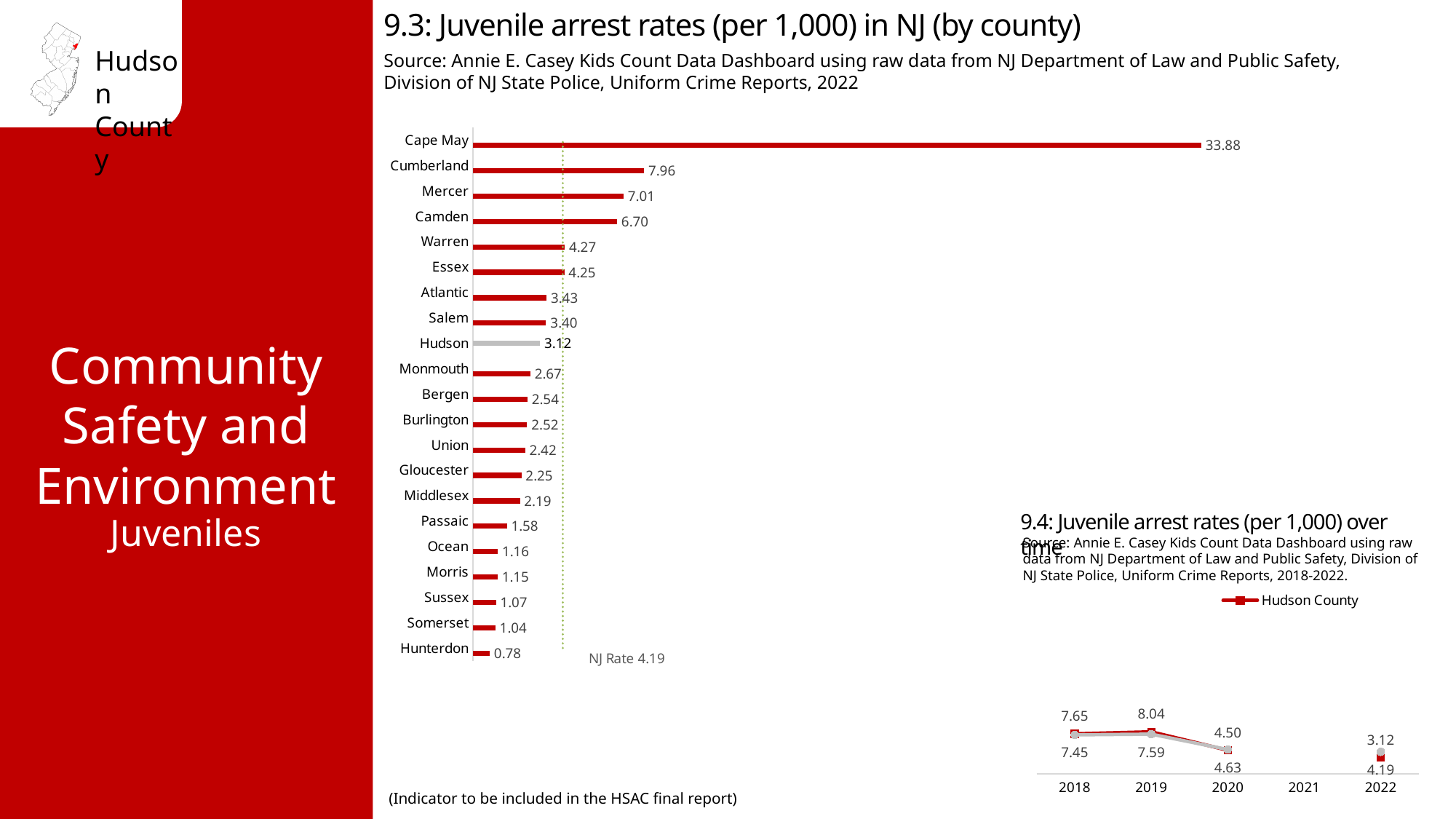
In the chart '9.4: Juvenile arrest rates (per 1,000) over time', what is the Hudson County value for 2022? 3.12 In the chart '9.3: Juvenile arrest rates (per 1,000) in NJ (by county)', what is the difference between the rates for Cape May and Cumberland? 25.92 In the chart '9.3: Juvenile arrest rates (per 1,000) in NJ (by county)', what is the juvenile arrest rate for Hudson? 3.12 In the chart '9.3: Juvenile arrest rates (per 1,000) in NJ (by county)', which county has the lowest juvenile arrest rate? Hunterdon In the chart '9.3: Juvenile arrest rates (per 1,000) in NJ (by county)', which county has the highest juvenile arrest rate? Cape May In the chart '9.3: Juvenile arrest rates (per 1,000) in NJ (by county)', how many counties are shown? 21 What kind of chart is '9.3: Juvenile arrest rates (per 1,000) in NJ (by county)'? Bar chart In the chart '9.3: Juvenile arrest rates (per 1,000) in NJ (by county)', what is the value for Cumberland? 7.96 In the chart '9.3: Juvenile arrest rates (per 1,000) in NJ (by county)', which has a higher juvenile arrest rate, Mercer or Camden? Mercer In the chart '9.4: Juvenile arrest rates (per 1,000) over time', how many years are shown on the x axis? 5 What kind of chart is '9.4: Juvenile arrest rates (per 1,000) over time'? Line chart In the chart '9.3: Juvenile arrest rates (per 1,000) in NJ (by county)', what NJ rate is marked by the dotted reference line? 4.19